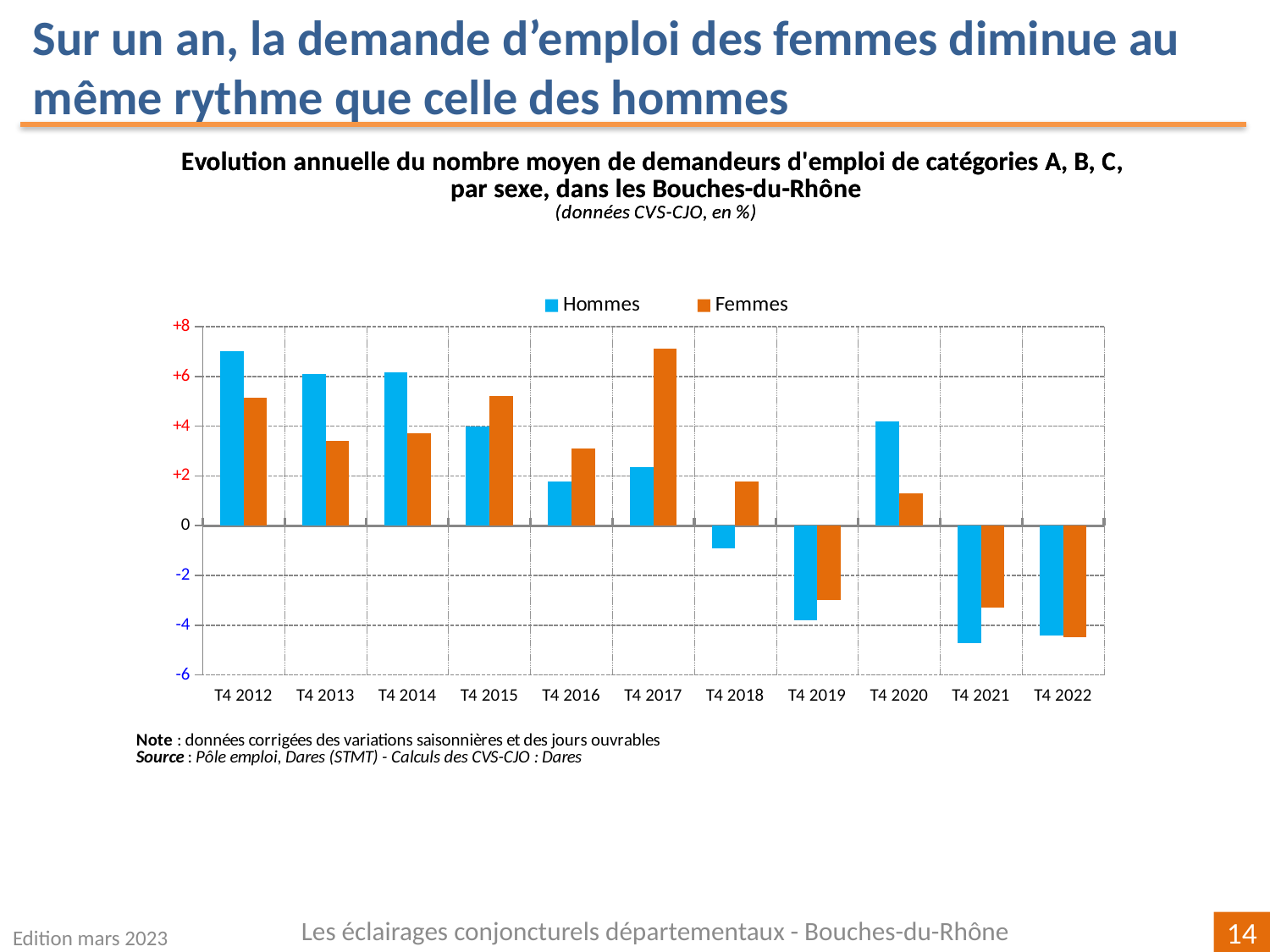
For T4 2020, which series has the larger value, Hommes or Femmes? Hommes What kind of chart is shown on the slide? bar chart Is the Femmes value for T4 2017 greater or less than +6? greater In which quarter is the Hommes value highest? T4 2012 How many series does the legend list? 2 Do the Hommes values rise or fall from T4 2012 to T4 2016? fall How many quarters (categories) are shown on the x axis? 11 In which quarter is the Femmes value highest? T4 2017 Is the Hommes value for T4 2012 greater or less than +6? greater In which quarter is the Femmes value lowest? T4 2022 For T4 2018, which series has the larger value, Hommes or Femmes? Femmes Is the Hommes value for T4 2019 greater or less than -2? less